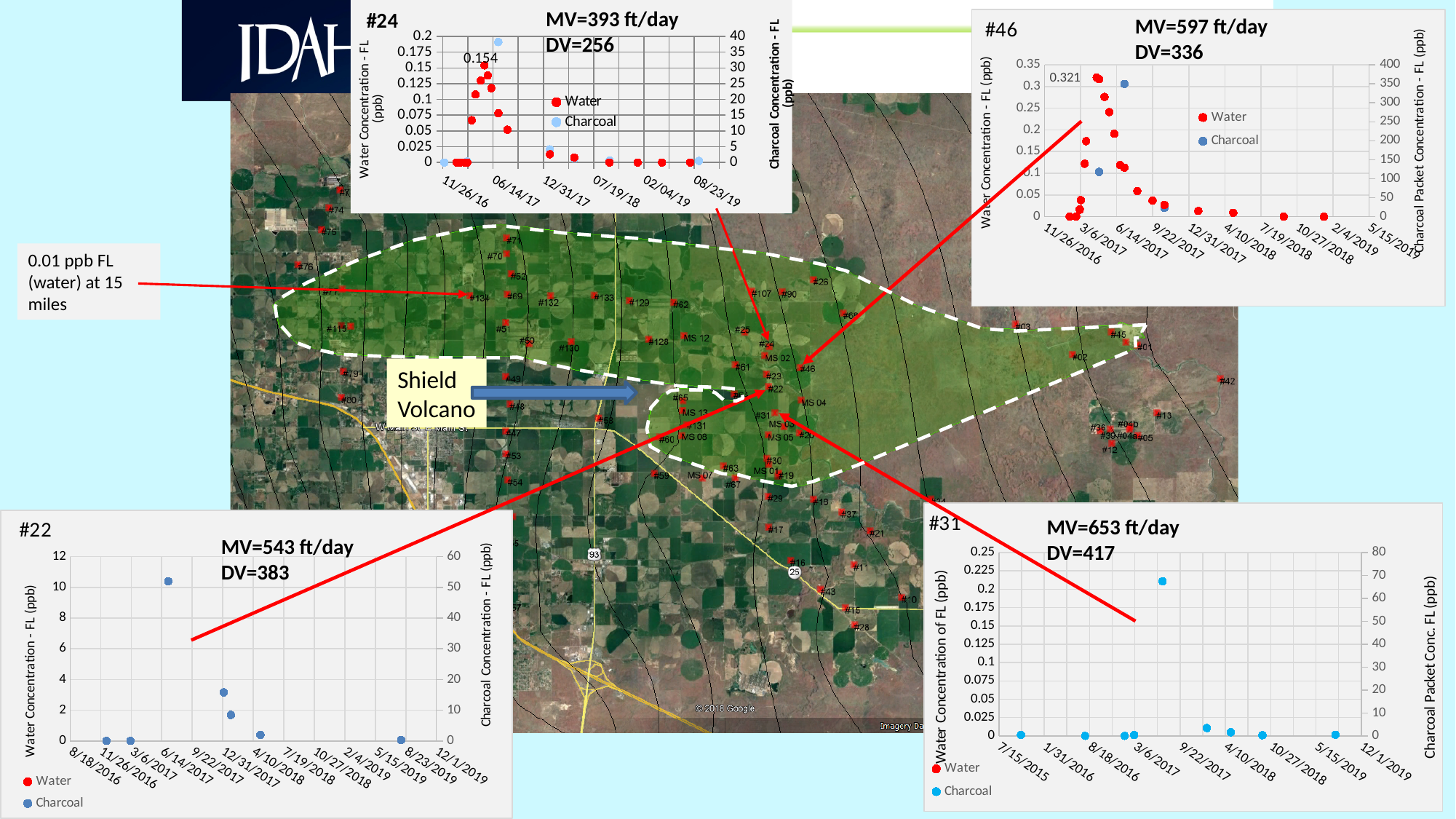
On the chart labelled #46, what MV value is shown in the title? 597 ft/day On the chart labelled #46, what is the value printed as a data label on the highest Water point? 0.321 On the chart labelled #24, what DV value is shown in the title? 256 What are the two legend entries on the chart labelled #46? Water and Charcoal On the chart labelled #24, what is the value printed as a data label on the highest Water point? 0.154 On the chart labelled #31, what DV value is shown in the title? 417 On the chart labelled #22, what MV value is shown in the title? 543 ft/day On the chart labelled #24, what MV value is shown in the title? 393 ft/day On the chart labelled #46, what DV value is shown in the title? 336 What kind of chart is the chart labelled #31? scatter chart How many series does the legend list on the chart labelled #22? 2